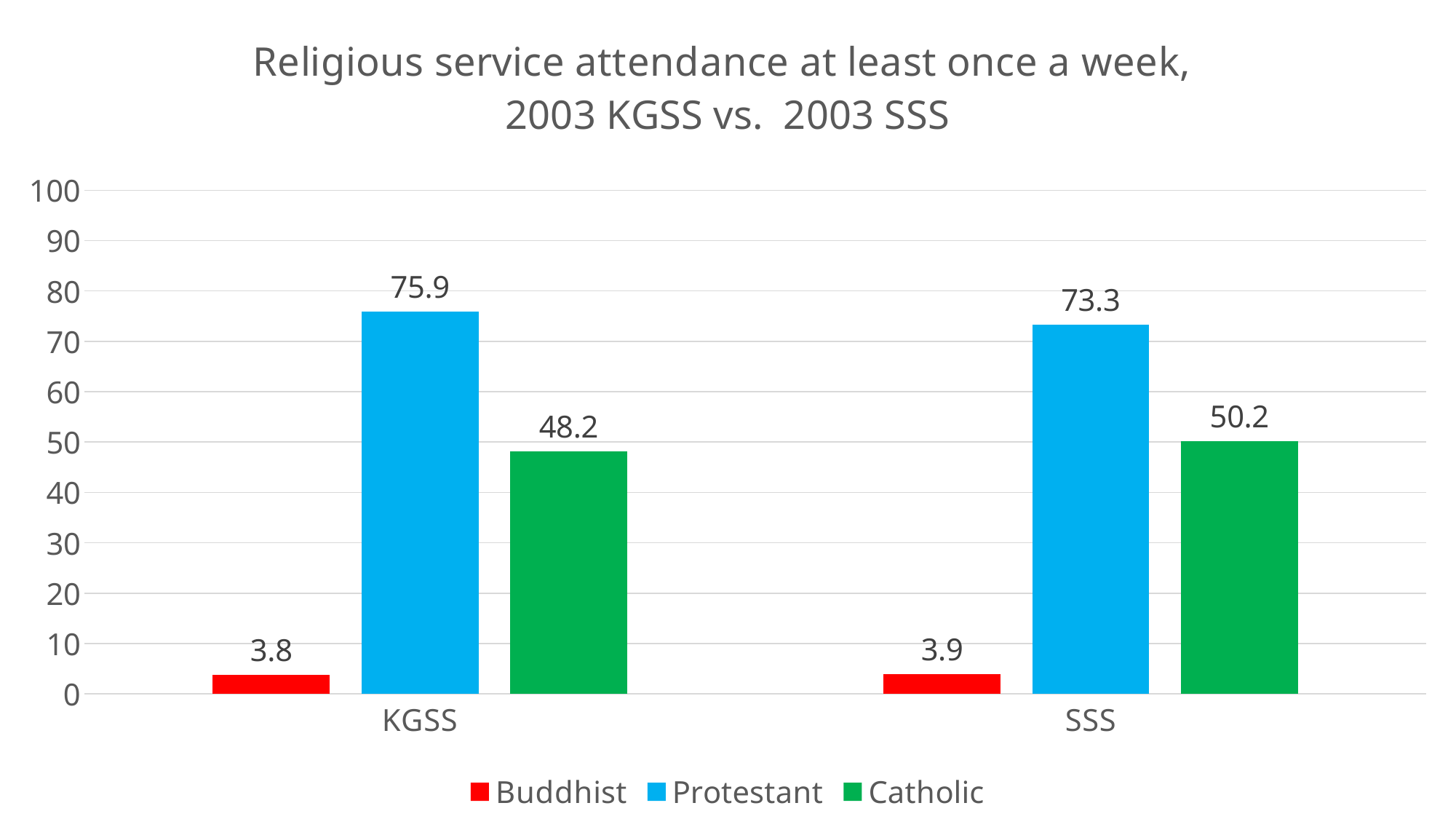
What is the value for Buddhist in the KGSS group? 3.8 What is the value for Protestant in the KGSS group? 75.9 What kind of chart is shown on the slide? bar chart What is the difference between the Protestant values for KGSS and SSS? 2.6 How many categories are shown on the x axis? 2 What is the difference between the Protestant and Catholic values in the KGSS group? 27.7 How many series does the legend list? 3 Which series has the lowest value in the KGSS group? Buddhist Is the Catholic value for KGSS greater or less than 50? less What is the value for Catholic in the SSS group? 50.2 Which series has the highest value in the SSS group? Protestant Which is larger, the Catholic value for KGSS or the Catholic value for SSS? SSS